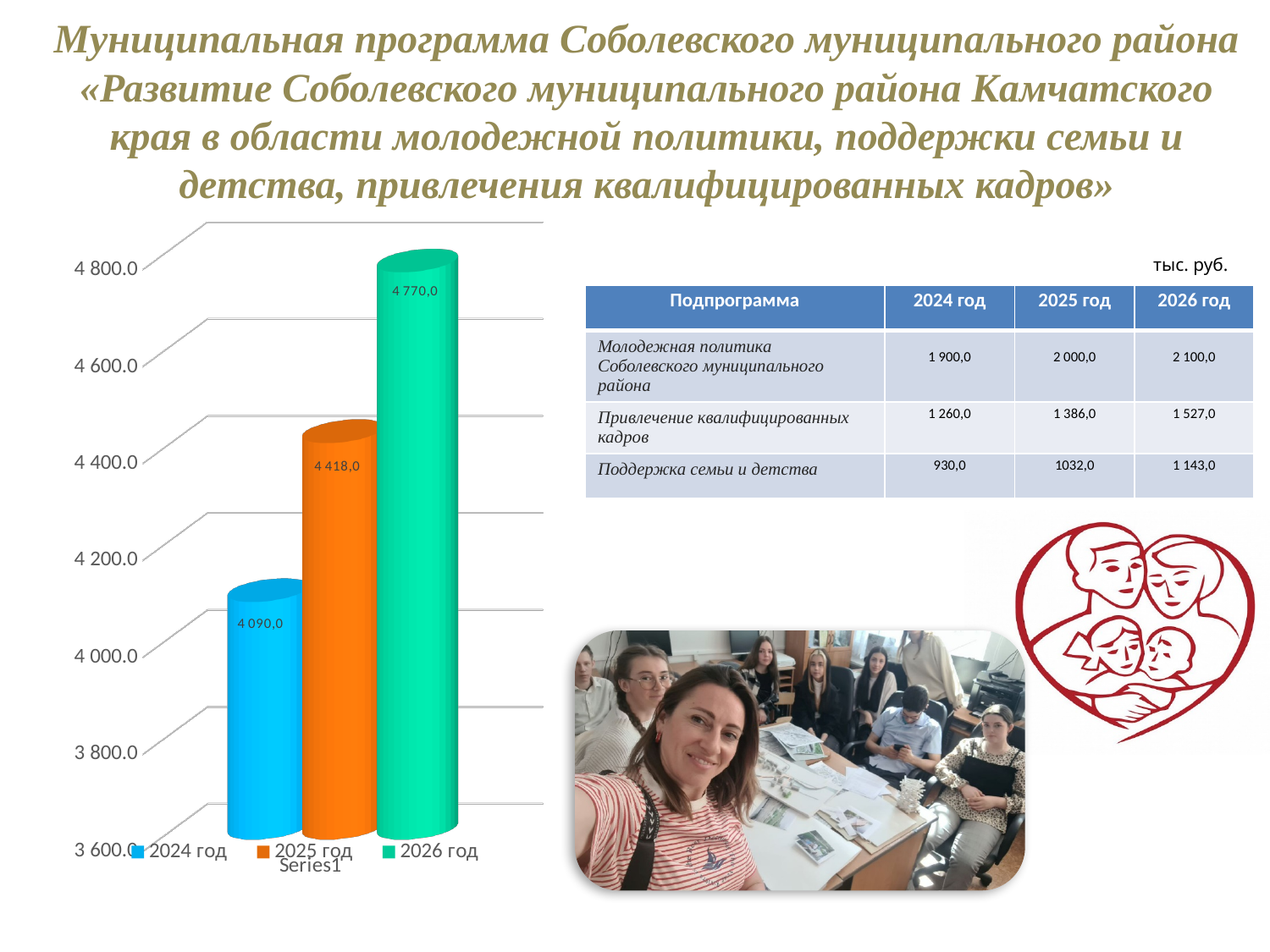
Which year has the highest value on the bar chart? 2026 год Do the values on the bar chart rise or fall from 2024 год to 2026 год? rise How many bars are plotted on the bar chart? 3 Which is larger on the bar chart, the value for 2025 год or the value for 2024 год? 2025 год What is the difference between the values for 2026 год and 2024 год on the bar chart? 680,0 Which year has the lowest value on the bar chart? 2024 год How many series does the legend of the bar chart list? 3 What is the value shown for 2024 год on the bar chart? 4 090,0 What is the value shown for 2025 год on the bar chart? 4 418,0 What is the difference between the values for 2025 год and 2024 год on the bar chart? 328,0 What is the value shown for 2026 год on the bar chart? 4 770,0 Is the value for 2025 год on the bar chart greater or less than 4 400.0? greater